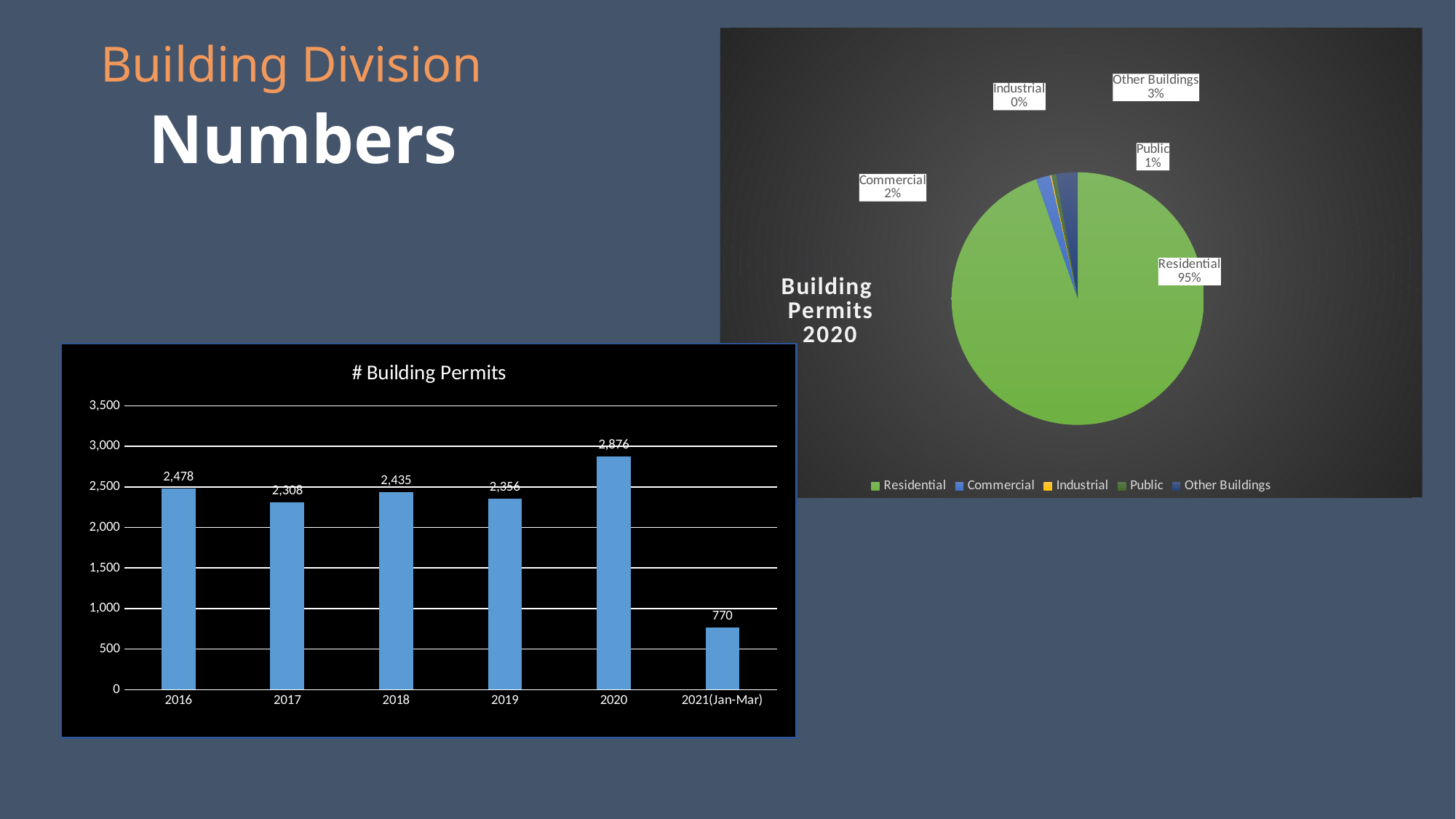
In the 'Building Permits 2020' pie chart, what share does Other Buildings have? 3% In the '# Building Permits' bar chart, what is the difference between the 2020 and 2019 values? 520 In the 'Building Permits 2020' pie chart, which category has the largest slice? Residential What type of chart is the '# Building Permits' chart? bar chart How many entries does the legend of the 'Building Permits 2020' pie chart list? 5 In the '# Building Permits' bar chart, what is the value for 2017? 2,308 In the 'Building Permits 2020' pie chart, what share does Residential have? 95% In the '# Building Permits' bar chart, which is larger, the value for 2016 or the value for 2018? 2016 In the '# Building Permits' bar chart, which category has the lowest value? 2021(Jan-Mar) In the '# Building Permits' bar chart, how many bars are shown? 6 In the '# Building Permits' bar chart, which year has the highest number of permits? 2020 In the '# Building Permits' bar chart, what is the value for 2020? 2,876